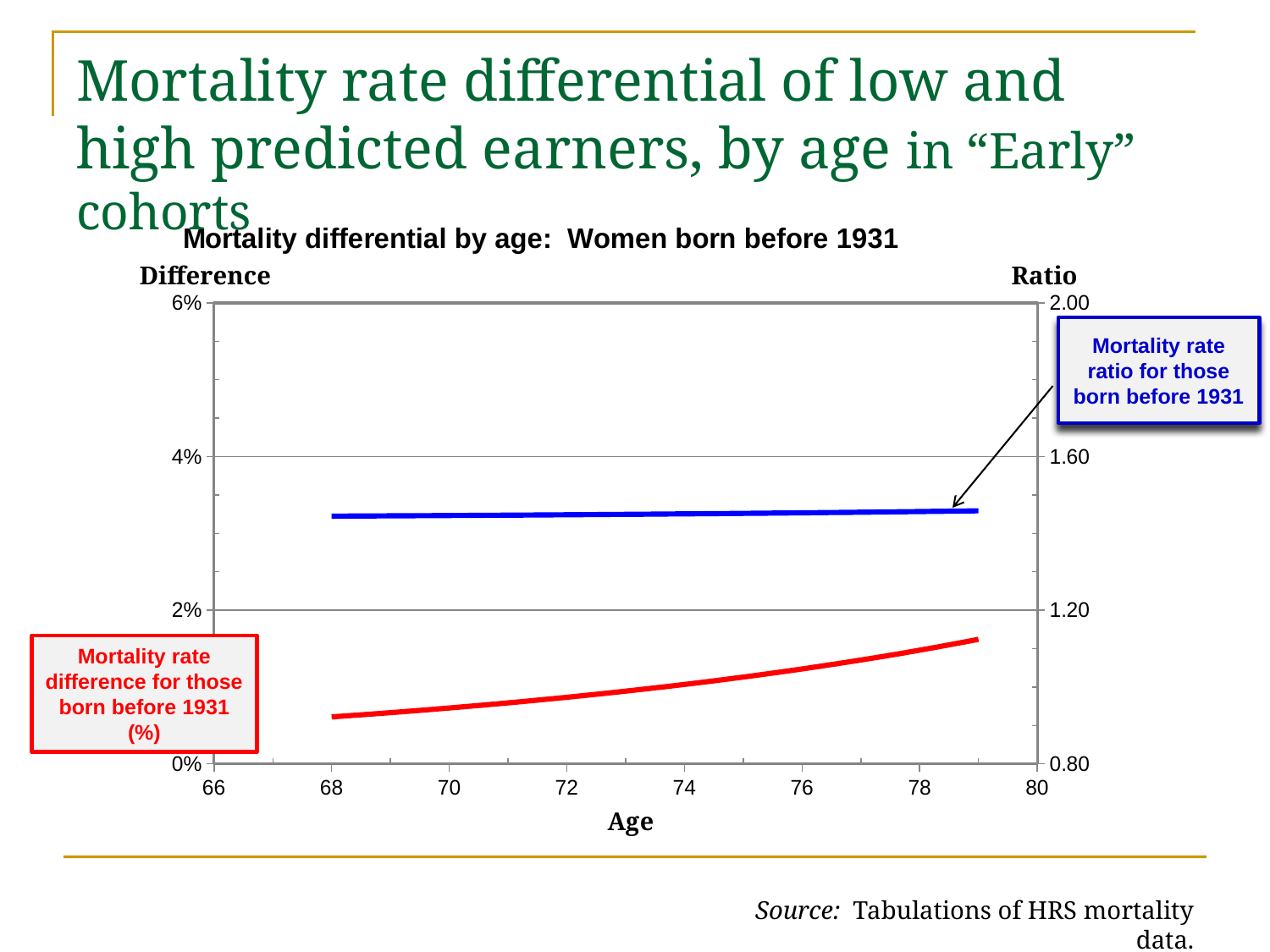
What is the highest value shown on the right-hand Ratio axis? 2.00 What kind of chart is shown on the slide? line chart Is the mortality rate difference at age 79 greater or less than 2%? less What is the lowest age shown on the x axis? 66 Does the red mortality rate difference line rise or fall as age increases? rises Is the mortality rate ratio at age 68 greater or less than 1.20? greater How many lines are plotted on the chart? 2 What is the label of the x axis? Age Is the mortality rate difference at age 68 greater or less than 2%? less Is the mortality rate difference larger at age 68 or at age 79? age 79 What is the title of the chart? Mortality differential by age: Women born before 1931